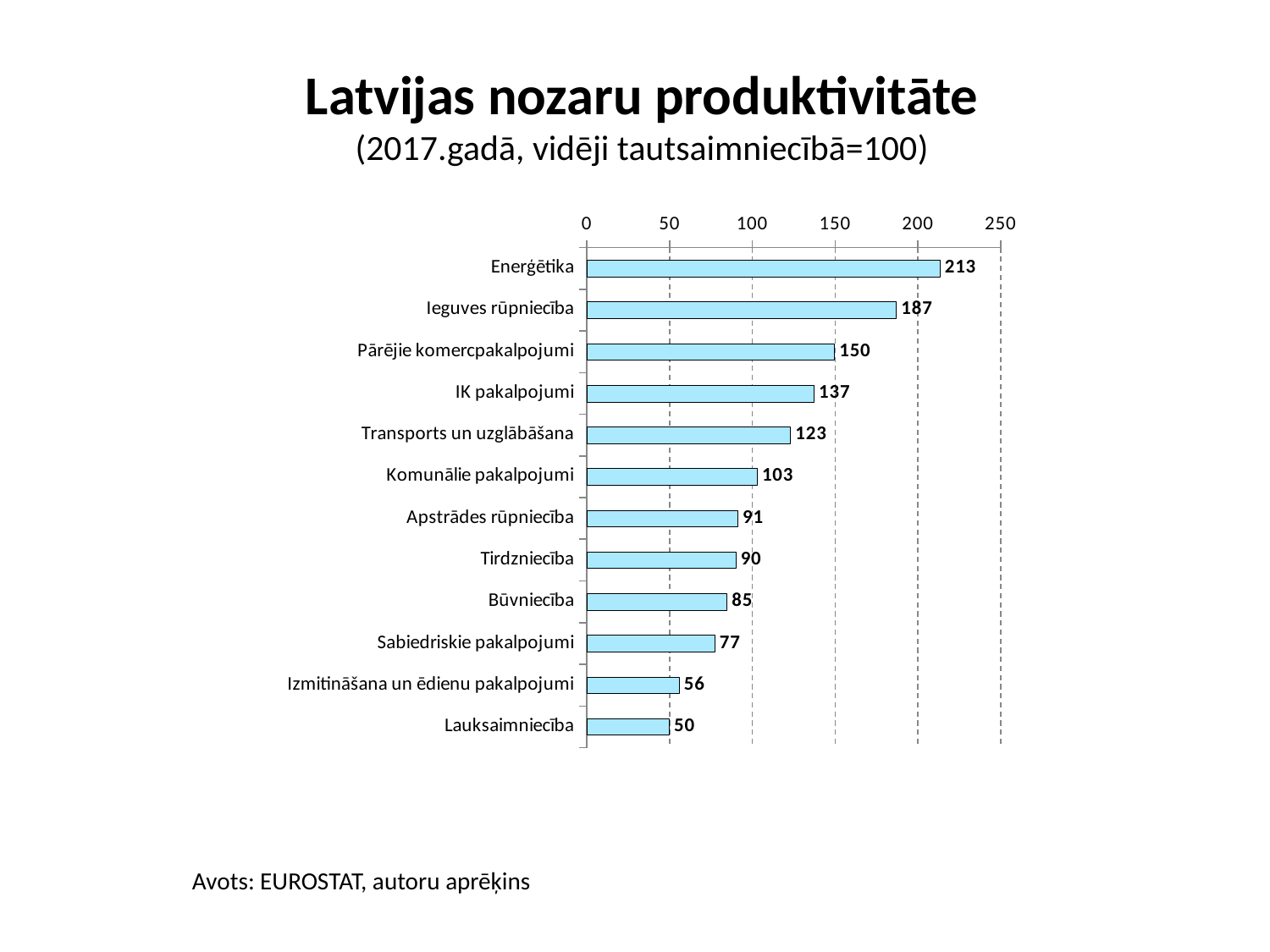
How many categories are shown in the chart? 12 What kind of chart is shown on the slide? bar chart What is the value for Transports un uzglabāšana? 123 Which category has the lowest value? Lauksaimniecība What is the difference between the values for Komunālie pakalpojumi and Lauksaimniecība? 53 Is the value for Sabiedriskie pakalpojumi greater or less than 100? less What is the value for Enerģētika? 213 What is the title of the chart on the slide? Latvijas nozaru produktivitāte What is the difference between the values for Enerģētika and Ieguves rūpniecība? 26 What is the value for Būvniecība? 85 Which category has the highest value? Enerģētika Which is larger, the value for IK pakalpojumi or the value for Tirdzniecība? IK pakalpojumi